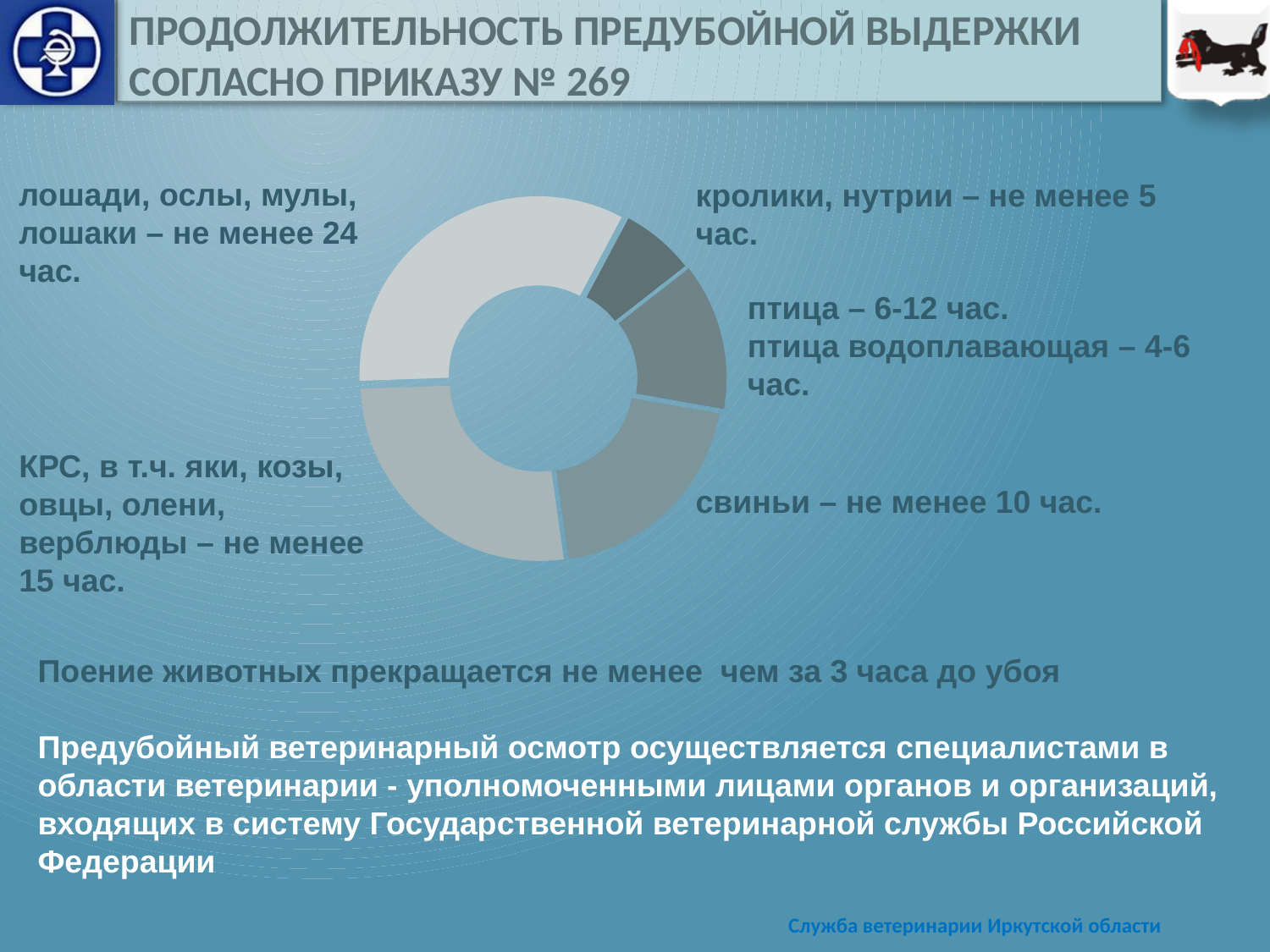
Which group has the longer minimum holding time on the slide: лошади (horses) or свиньи (pigs)? лошади What kind of chart is shown on the slide? Donut (pie) chart Does the donut chart on the slide have a legend? No According to the slide, what is the minimum pre-slaughter holding time for кролики, нутрии? не менее 5 час. According to the slide, what is the pre-slaughter holding time for птица водоплавающая? 4-6 час. How many slices does the donut chart have? 5 According to the slide, what is the minimum pre-slaughter holding time for лошади, ослы, мулы, лошаки? не менее 24 час. What is the title of the slide containing the chart? ПРОДОЛЖИТЕЛЬНОСТЬ ПРЕДУБОЙНОЙ ВЫДЕРЖКИ СОГЛАСНО ПРИКАЗУ № 269 According to the slide, what is the minimum pre-slaughter holding time for свиньи (pigs)? не менее 10 час. According to the slide, what is the minimum pre-slaughter holding time for КРС, в т.ч. яки, козы, овцы, олени, верблюды? не менее 15 час.